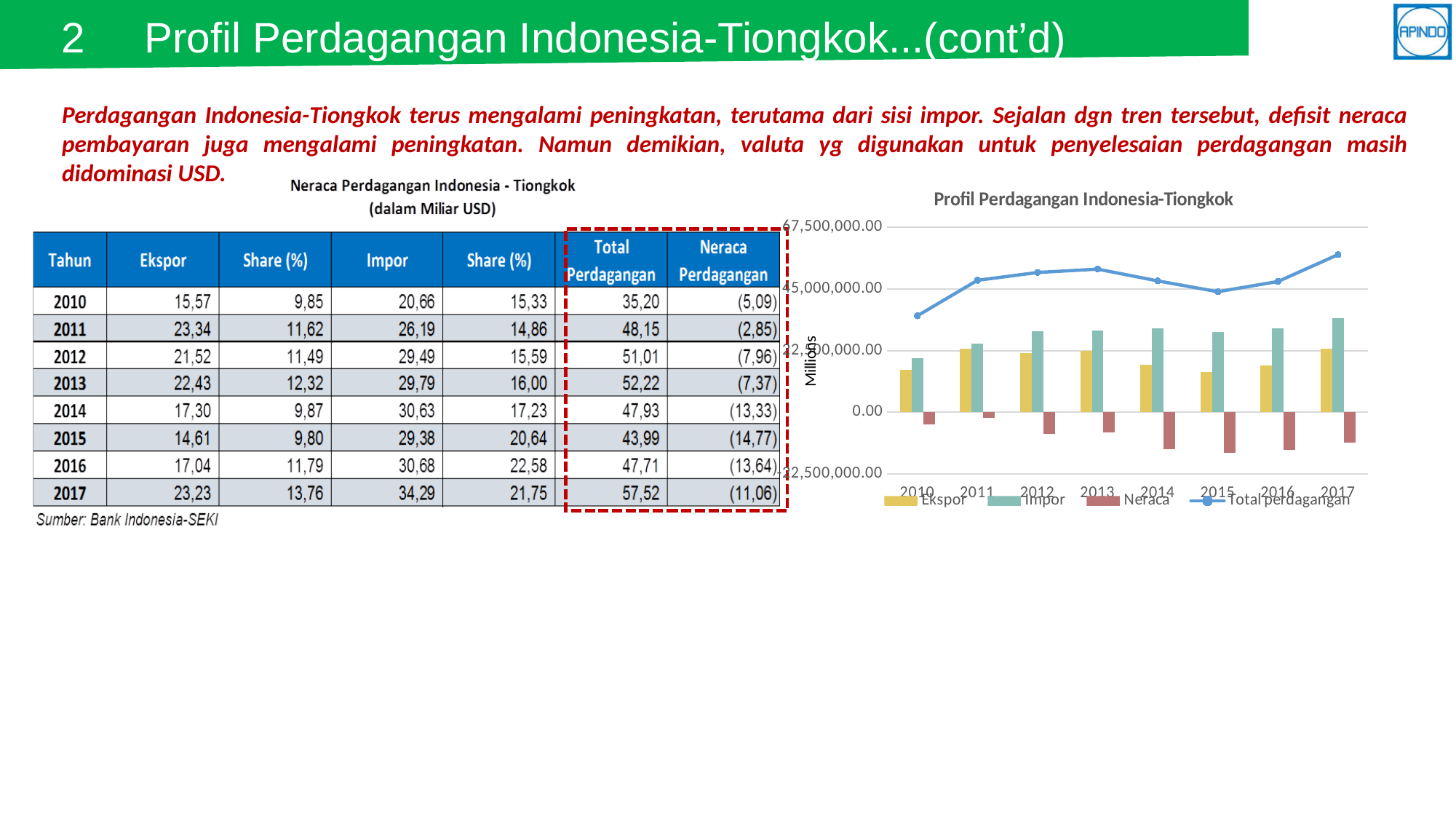
In the chart, is the Ekspor value for 2015 greater or less than 22,500,000.00? less How many years are shown on the x axis of the chart? 8 In the chart, which is larger in 2017: Ekspor or Impor? Impor In the chart, which year has the lowest value for Total perdagangan? 2010 In the chart, which year has the highest Impor bar? 2017 In the chart, is the Total perdagangan value for 2010 greater or less than 45,000,000.00? less What kind of chart is the 'Profil Perdagangan Indonesia-Tiongkok' chart? A combined bar and line chart How many series does the legend of the chart list? 4 In the chart, which year has the highest value for Total perdagangan? 2017 In the chart, does the Total perdagangan line rise or fall from 2010 to 2013? rise In the chart, is the Total perdagangan value for 2017 greater or less than 45,000,000.00? greater What is the title of the chart on the right side of the slide? Profil Perdagangan Indonesia-Tiongkok